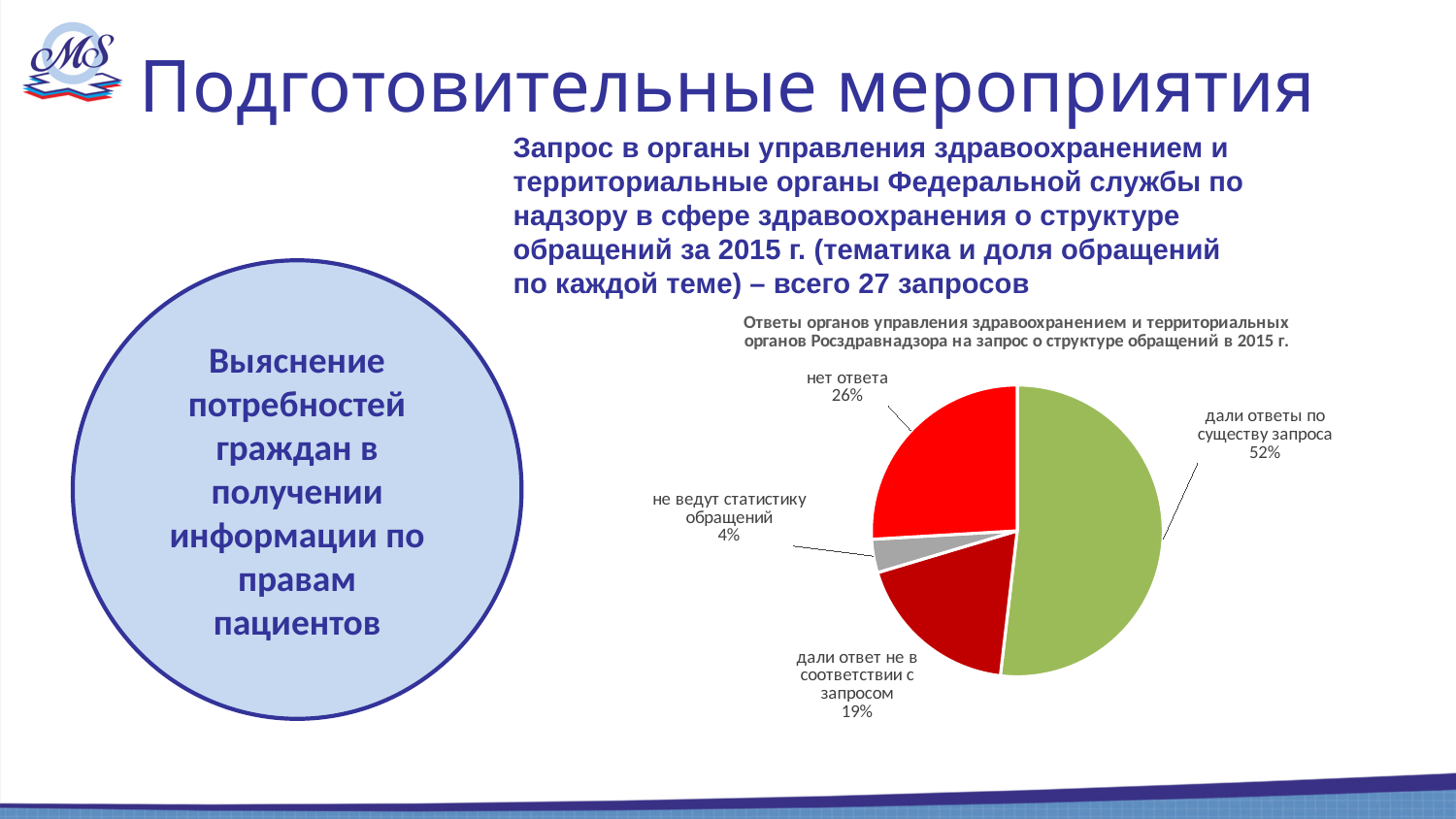
What share of the pie is labelled "дали ответы по существу запроса"? 52% What share of the pie is labelled "дали ответ не в соответствии с запросом"? 19% Which slice of the pie chart is the smallest? не ведут статистику обращений What is the difference in percentage points between "дали ответы по существу запроса" and "нет ответа"? 26 Which is larger: the share for "нет ответа" or the share for "дали ответ не в соответствии с запросом"? нет ответа How many slices does the pie chart have? 4 What is the difference in percentage points between "нет ответа" and "дали ответ не в соответствии с запросом"? 7 What share of the pie is labelled "нет ответа"? 26% What type of chart is shown on the slide? pie chart What share of the pie is labelled "не ведут статистику обращений"? 4% What colour is the slice for "дали ответы по существу запроса"? green Which slice of the pie chart is the largest? дали ответы по существу запроса